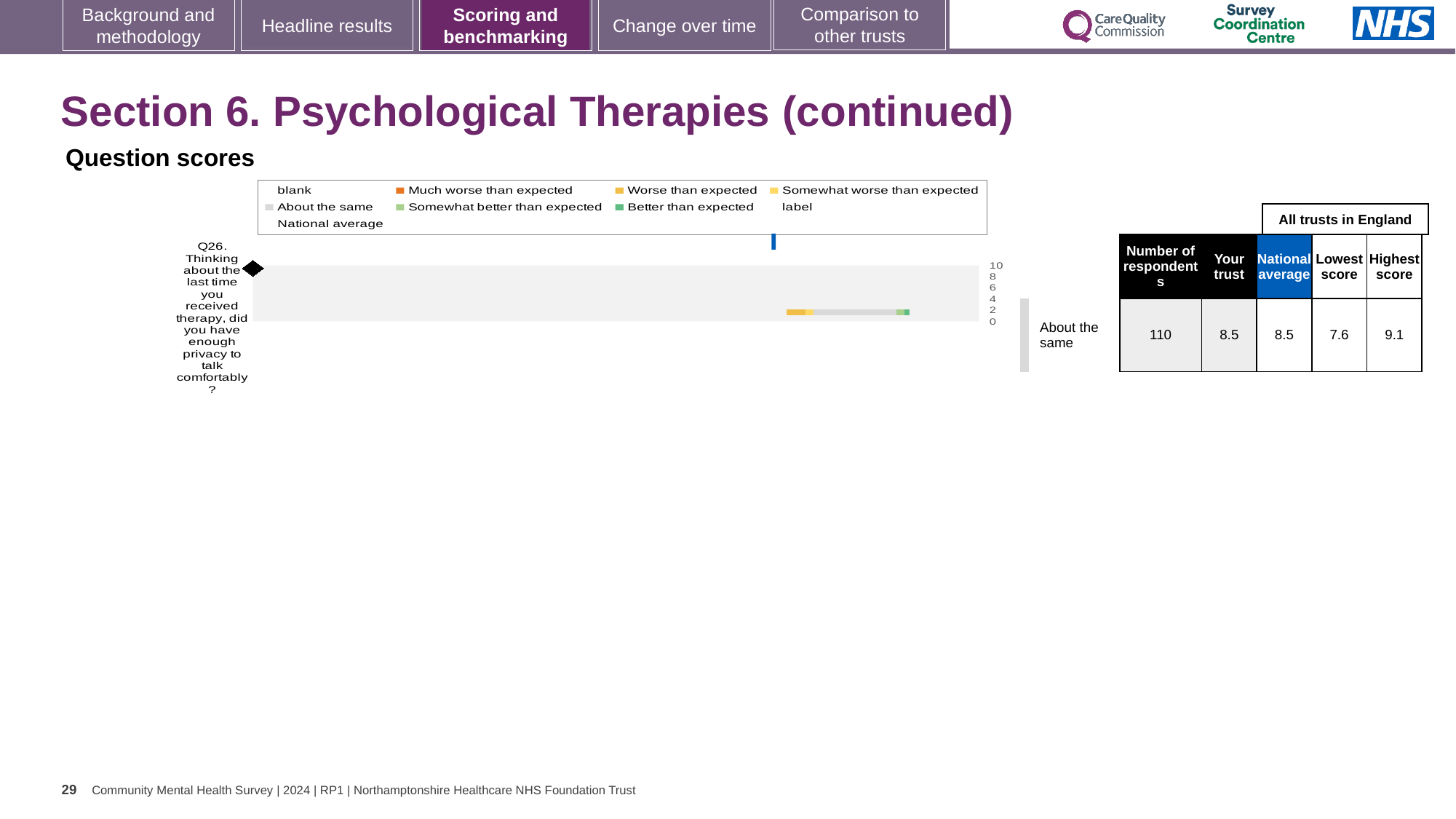
What is the 'Your trust' score for Q26? 8.5 What colour does the legend use for 'Better than expected'? green Which question is plotted on the chart? Q26. Thinking about the last time you received therapy, did you have enough privacy to talk comfortably? Which is larger for Q26, the highest score or the 'Your trust' score? Highest score What is the national average score for Q26? 8.5 What is the highest score among all trusts in England for Q26? 9.1 What is the difference between the highest score and the lowest score for Q26? 1.5 What benchmark category is shown for Q26 next to the chart? About the same What kind of chart is shown under 'Question scores'? bar chart How many survey questions are plotted on the chart? 1 What is the lowest score among all trusts in England for Q26? 7.6 How many respondents answered Q26? 110